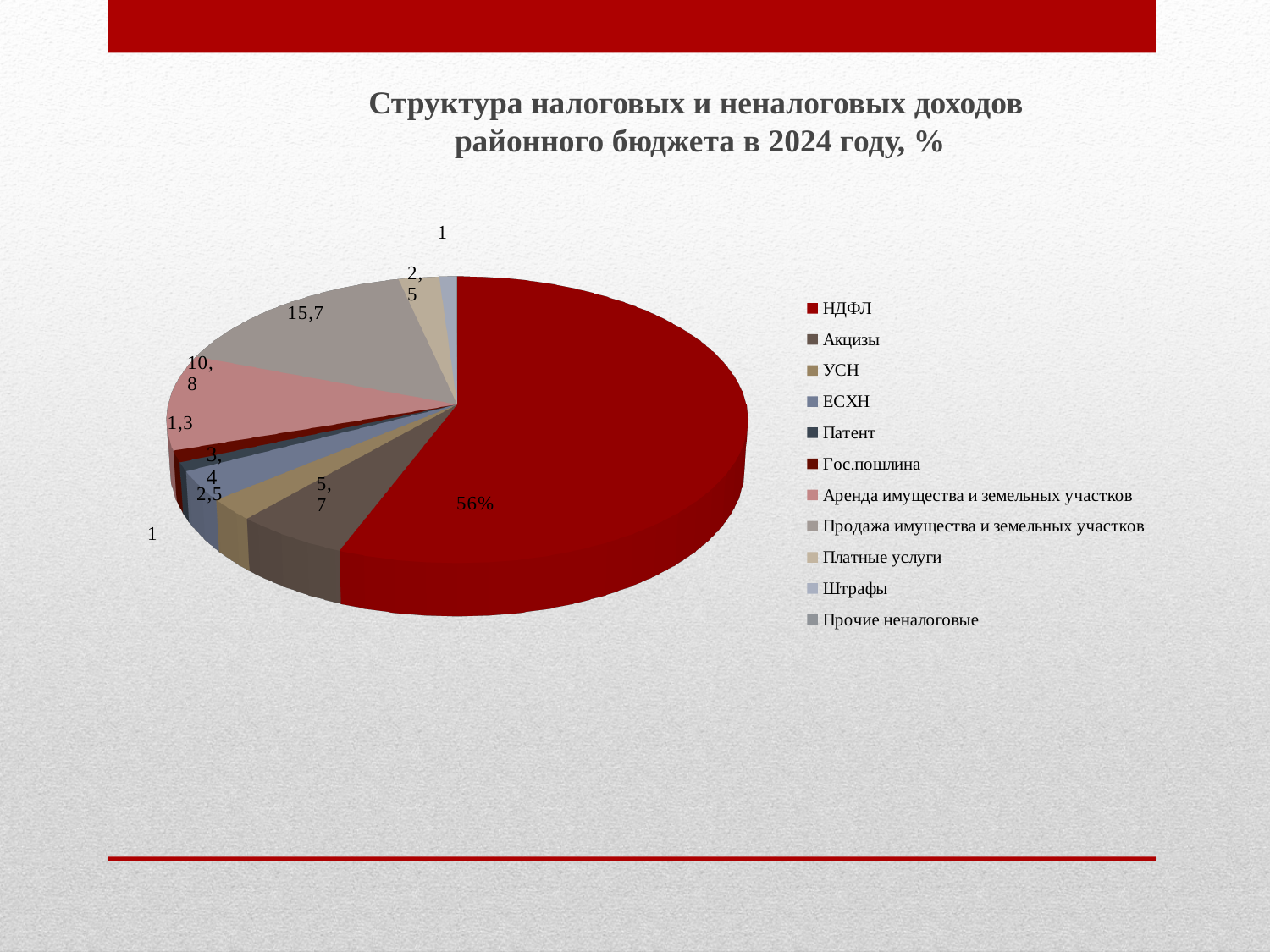
What share is shown for НДФЛ? 56% How many categories does the legend list? 11 What is the title of the chart? Структура налоговых и неналоговых доходов районного бюджета в 2024 году, % Which is larger: Аренда имущества и земельных участков or Продажа имущества и земельных участков? Продажа имущества и земельных участков What value is shown for ЕСХН? 3,4 What is the difference between the values for Продажа имущества и земельных участков and Аренда имущества и земельных участков? 4,9 What value is shown for Продажа имущества и земельных участков? 15,7 Which category has the largest share of the pie? НДФЛ What value is shown for Аренда имущества и земельных участков? 10,8 Which is larger: Акцизы or ЕСХН? Акцизы What kind of chart is shown on the slide? Pie chart What value is shown for Акцизы? 5,7